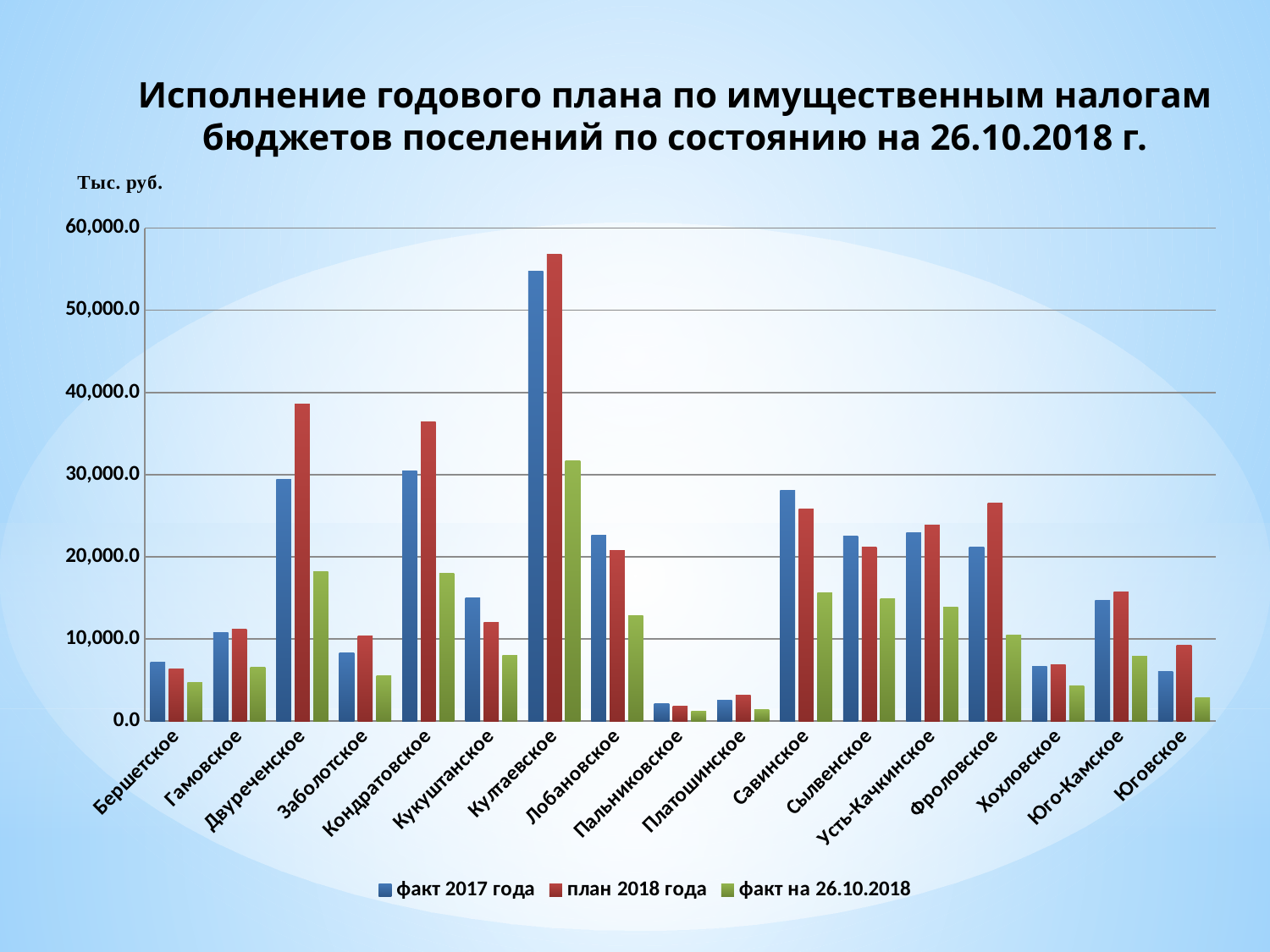
How many settlements (categories) are shown on the x axis? 17 For Фроловское, which is larger: факт 2017 года or план 2018 года? план 2018 года Is the value for Савинское in the факт на 26.10.2018 series greater or less than 20,000.0? less Which settlement has the lowest value for план 2018 года? Пальниковское Is the value for Двуреченское in the план 2018 года series greater or less than 30,000.0? greater How many series does the legend list? 3 Which settlement has the highest value for план 2018 года? Култаевское What kind of chart is shown on the slide? bar chart Is the value for Хохловское in the факт 2017 года series greater or less than 10,000.0? less Which colour represents the факт на 26.10.2018 series in the legend? green For Савинское, which is larger: факт 2017 года or план 2018 года? факт 2017 года